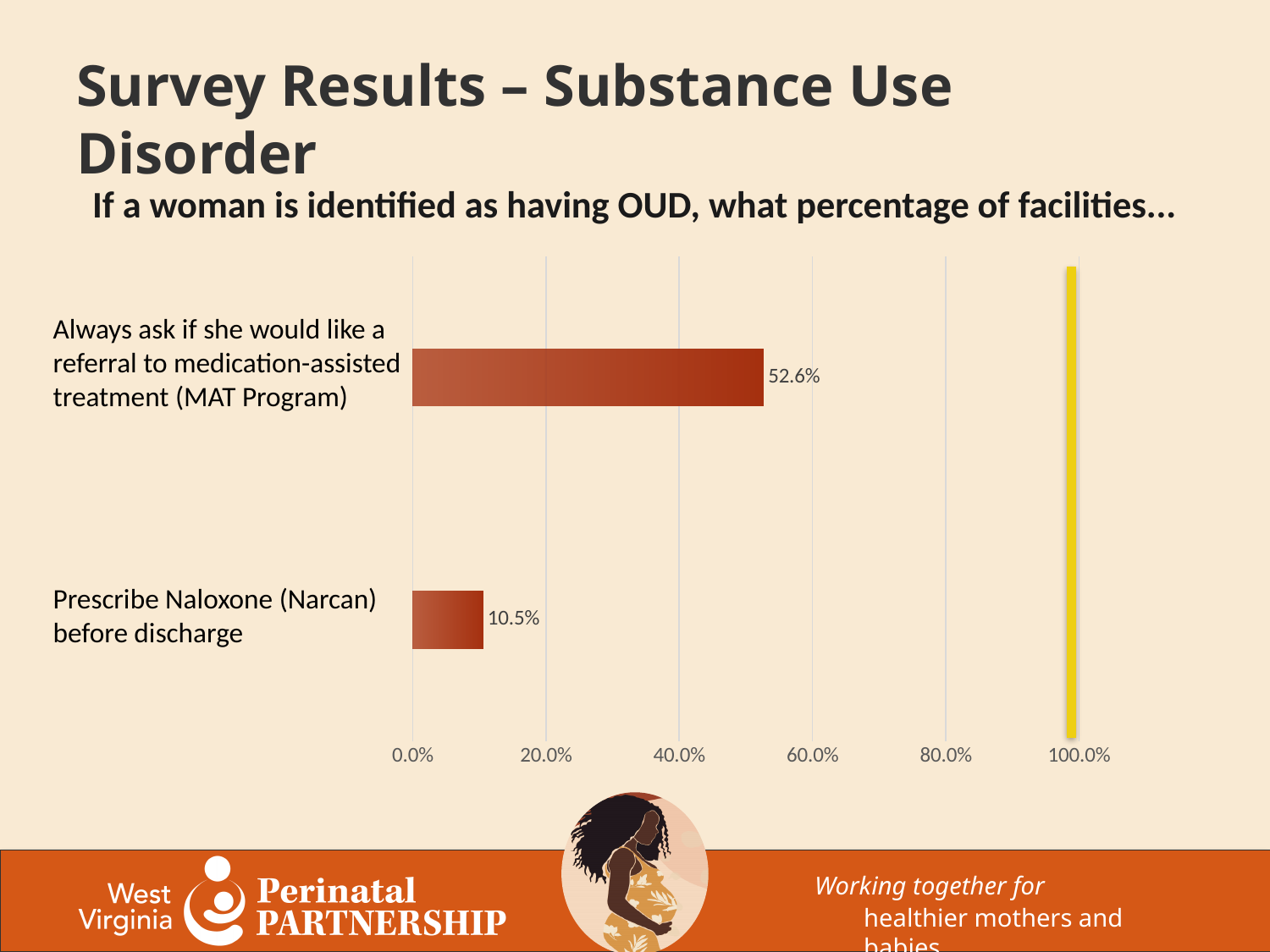
What percentage of facilities prescribe Naloxone (Narcan) before discharge? 10.5% What is the highest value shown on the x axis? 100.0% Is the value for always asking about a MAT Program referral greater or less than 40.0%? greater Which category has the highest value? Always ask if she would like a referral to medication-assisted treatment (MAT Program) Which is larger: the value for always asking about a MAT Program referral or the value for prescribing Naloxone before discharge? Always ask if she would like a referral to medication-assisted treatment (MAT Program) What kind of chart is shown on the slide? Bar chart How many categories are shown in the chart? 2 What is the difference between the value for the MAT Program referral and the value for prescribing Naloxone before discharge? 42.1% What is the question shown above the chart? If a woman is identified as having OUD, what percentage of facilities... Which category has the lowest value? Prescribe Naloxone (Narcan) before discharge What percentage of facilities always ask if she would like a referral to medication-assisted treatment (MAT Program)? 52.6% Is the value for prescribing Naloxone (Narcan) before discharge greater or less than 20.0%? less